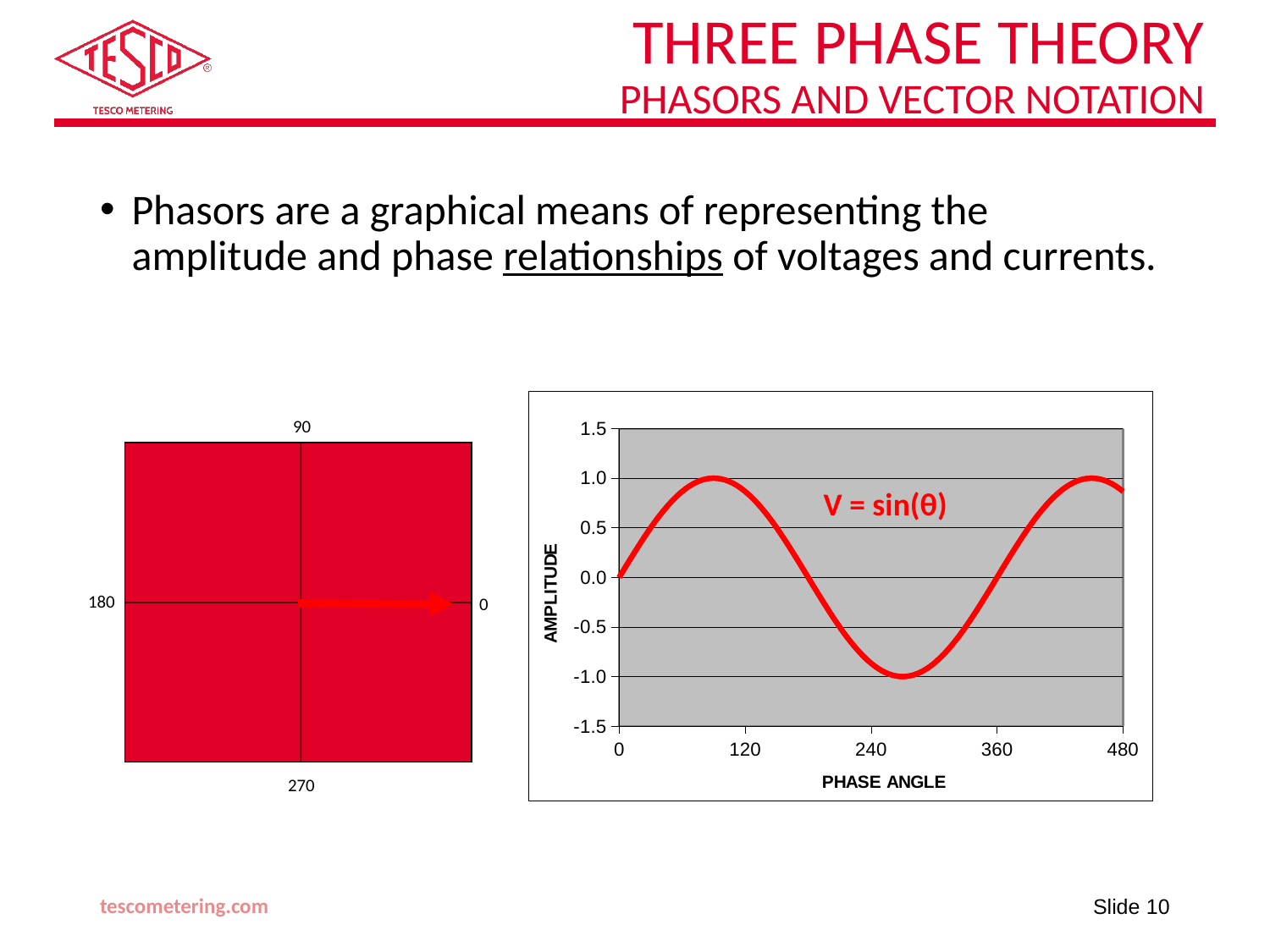
In the right-hand chart, is the amplitude at a phase angle of 120 greater or less than 0.5? greater What kind of chart is shown on the right side of the slide? line chart In the right-hand chart, what is the amplitude at a phase angle of 360? 0.0 In the right-hand chart, what is the minimum amplitude reached by the curve? -1.0 In the right-hand chart, what is the maximum amplitude reached by the curve? 1.0 In the right-hand chart, is the amplitude at a phase angle of 240 greater or less than -0.5? less What equation is written on the right-hand chart? V = sin(θ) In the right-hand chart, how many tick labels are shown on the phase angle axis? 5 In the right-hand chart, does the amplitude rise or fall as the phase angle goes from 120 to 240? fall What is the label of the horizontal axis of the right-hand chart? PHASE ANGLE In the right-hand chart, what is the amplitude at a phase angle of 0? 0.0 In the right-hand chart, does the amplitude rise or fall as the phase angle goes from 0 to 90? rise